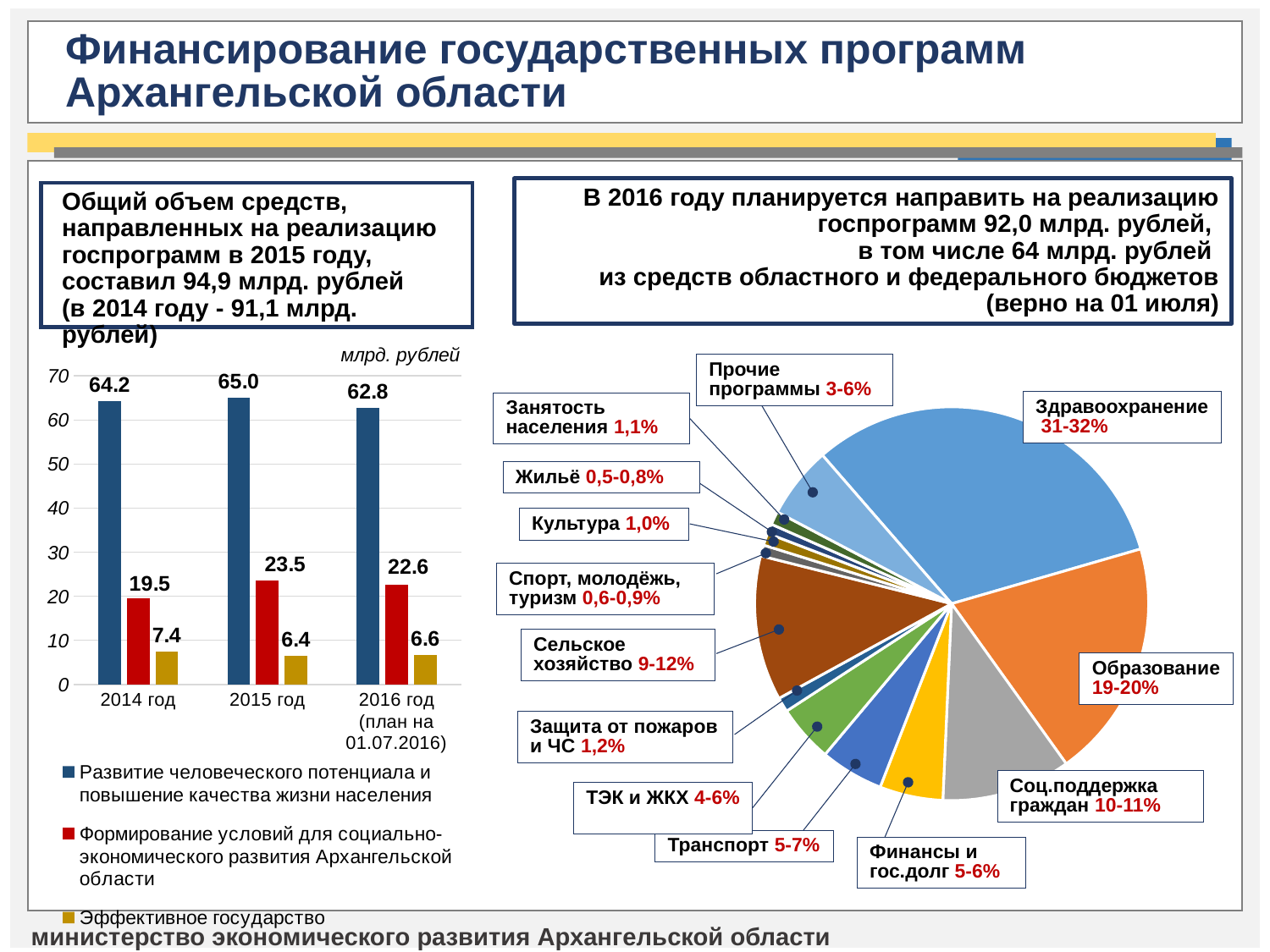
How many series does the legend of the bar chart on the left list? 3 On the bar chart on the left, what is the value for 'Эффективное государство' in 2016 год (план на 01.07.2016)? 6.6 What kind of chart is the chart on the left of the slide? bar chart On the bar chart on the left, in which year is the 'Эффективное государство' series lowest? 2015 год On the bar chart on the left, in which year is the 'Развитие человеческого потенциала и повышение качества жизни населения' series highest? 2015 год On the bar chart on the left, which is larger: the 'Эффективное государство' value for 2014 год or for 2016 год? 2014 год On the pie chart on the right, what share is shown for 'Здравоохранение'? 31-32% On the bar chart on the left, what is the value for 'Формирование условий для социально-экономического развития Архангельской области' in 2014 год? 19.5 On the bar chart on the left, what is the difference between the 'Формирование условий для социально-экономического развития Архангельской области' values for 2015 год and 2014 год? 4.0 On the pie chart on the right, which category has the largest slice? Здравоохранение On the pie chart on the right, what share is shown for 'Соц.поддержка граждан'? 10-11% On the bar chart on the left, what is the value for 'Развитие человеческого потенциала и повышение качества жизни населения' in 2015 год? 65.0